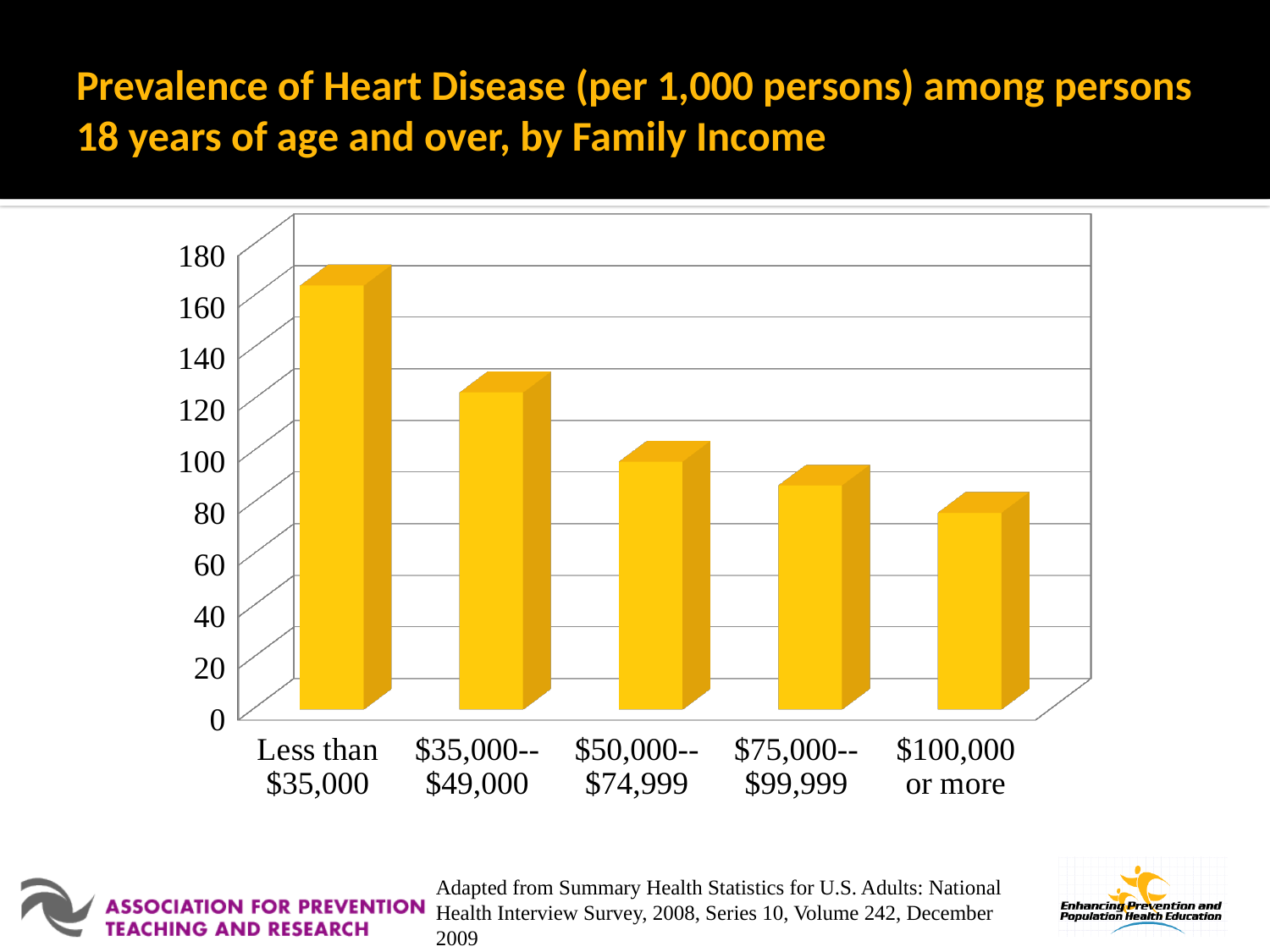
Is the value for Less than $35,000 greater or less than 140? greater How many family income categories are shown on the x axis? 5 Which is larger, the value for $35,000--$49,000 or the value for $75,000--$99,999? $35,000--$49,000 Which family income category has the lowest prevalence of heart disease? $100,000 or more Which family income category has the highest prevalence of heart disease? Less than $35,000 Is the value for $100,000 or more greater or less than 60? greater What is the title of the chart on the slide? Prevalence of Heart Disease (per 1,000 persons) among persons 18 years of age and over, by Family Income Is the value for $35,000--$49,000 greater or less than 100? greater What kind of chart is shown on the slide? Bar chart Do the values rise or fall as family income increases along the x axis? Fall